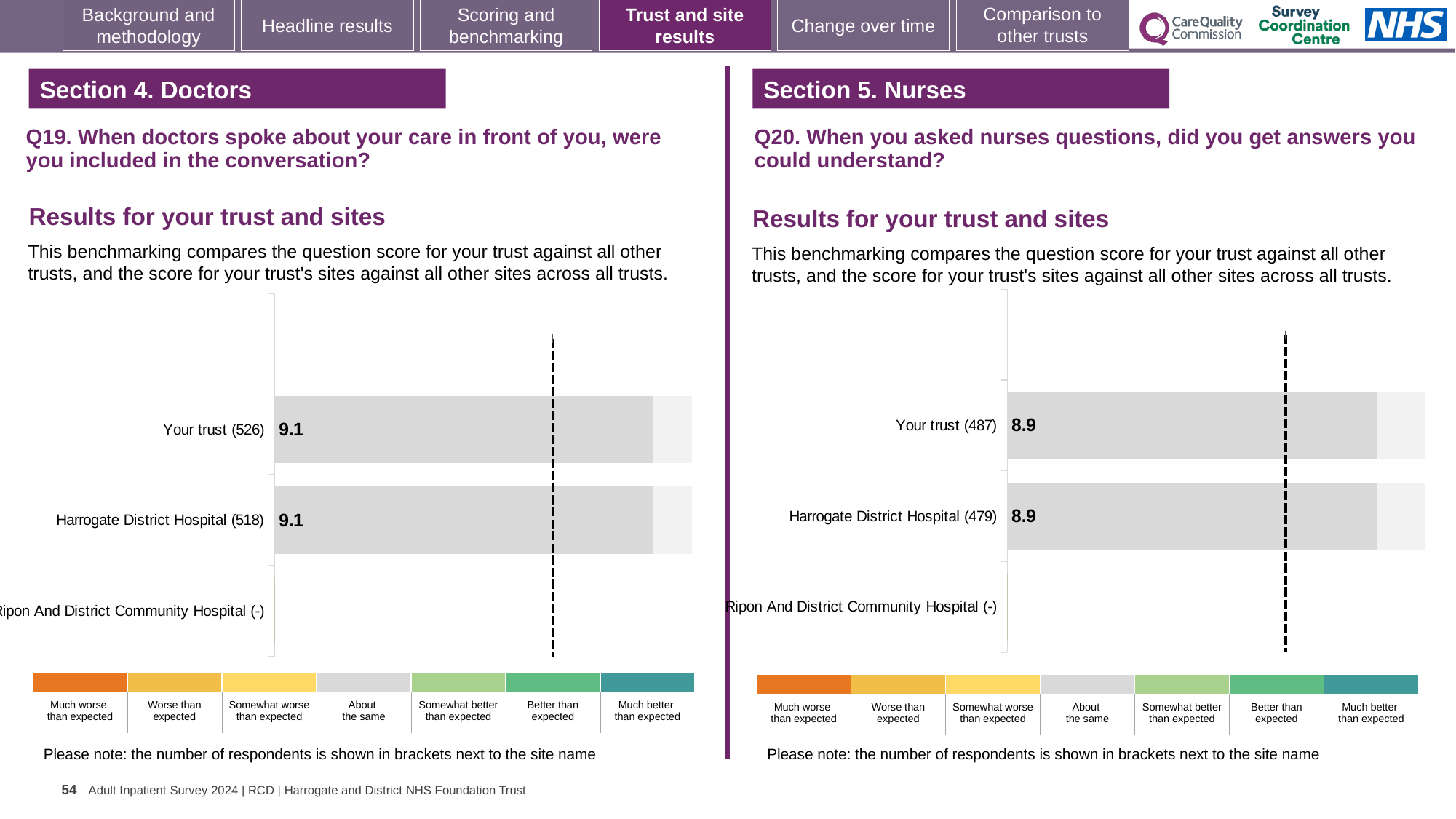
In the Q20 chart on the right, what is the score for Your trust? 8.9 In the Q19 chart on the left, what is the score for Your trust? 9.1 In the Q19 chart on the left, what is the score for Harrogate District Hospital? 9.1 In the Q20 chart on the right, what is the difference between the score for Your trust and the score for Harrogate District Hospital? 0 In the Q19 chart on the left, what is the difference between the score for Your trust and the score for Harrogate District Hospital? 0 In the Q19 chart on the left, how many respondents are shown in brackets for Your trust? 526 In the Q20 chart on the right, how many respondents are shown in brackets for Harrogate District Hospital? 479 How many site or trust categories are listed on the y axis of the Q20 chart on the right? 3 What kind of chart is the Q19 chart on the left? Bar chart Is the score for Your trust in the Q19 chart on the left larger or smaller than the score for Your trust in the Q20 chart on the right? Larger In the Q20 chart on the right, what is the score for Harrogate District Hospital? 8.9 How many site or trust categories are listed on the y axis of the Q19 chart on the left? 3